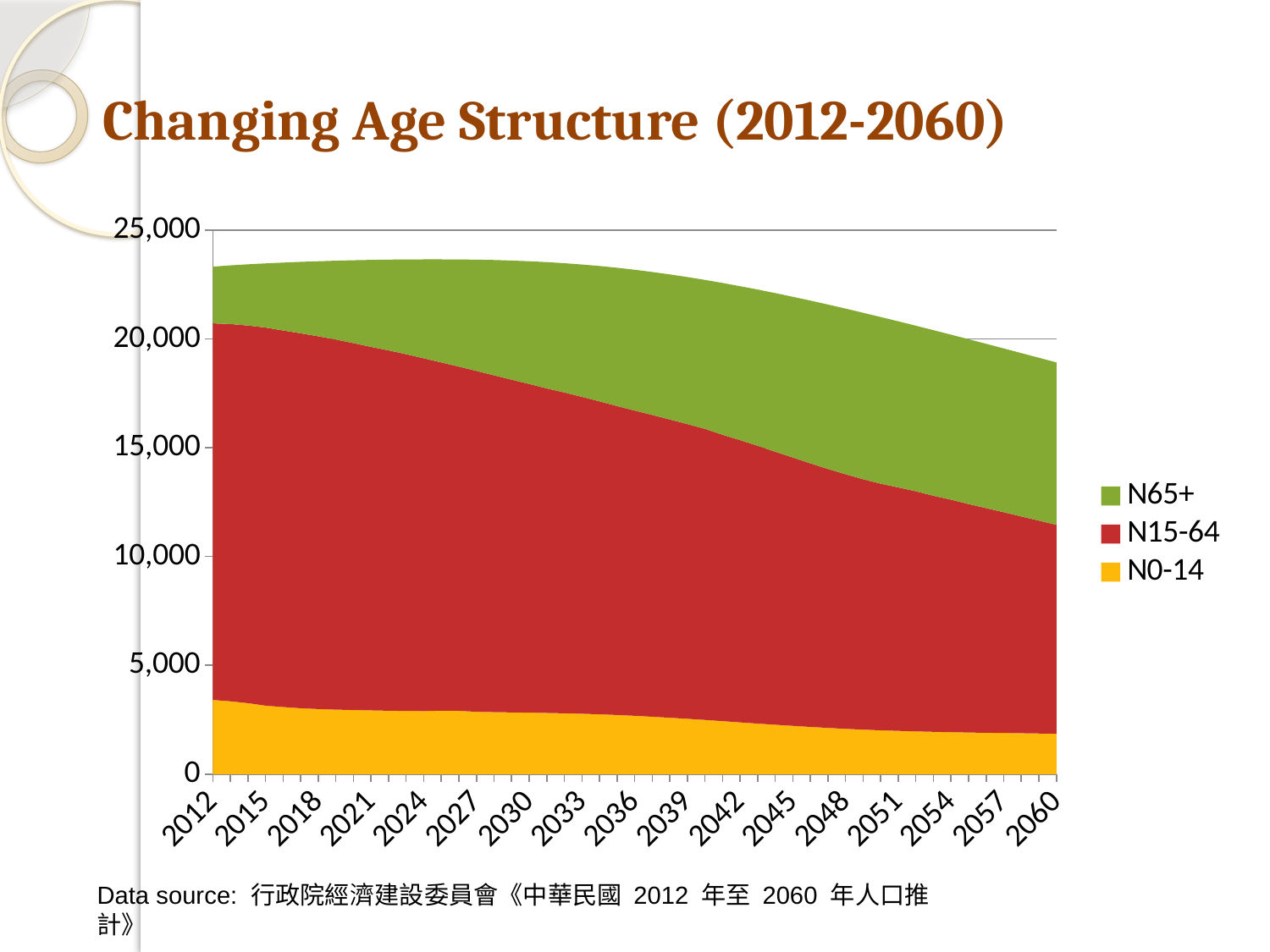
Does the N15-64 band get thicker or thinner from 2012 to 2060? Thinner Is the value for N0-14 in 2012 greater or less than 5,000? less How many series does the legend list? 3 How many year labels are shown on the x axis? 17 What kind of chart is shown on the slide? Stacked area chart Which series is shown in green in the legend? N65+ Does the N65+ band get thicker or thinner from 2012 to 2060? Thicker Is the total stacked value in 2060 greater or less than 20,000? less Is the top of the N15-64 band in 2060 greater or less than 10,000? greater Overall, does the total stacked value rise or fall from 2012 to 2060? Falls What is the title of the chart? Changing Age Structure (2012-2060)